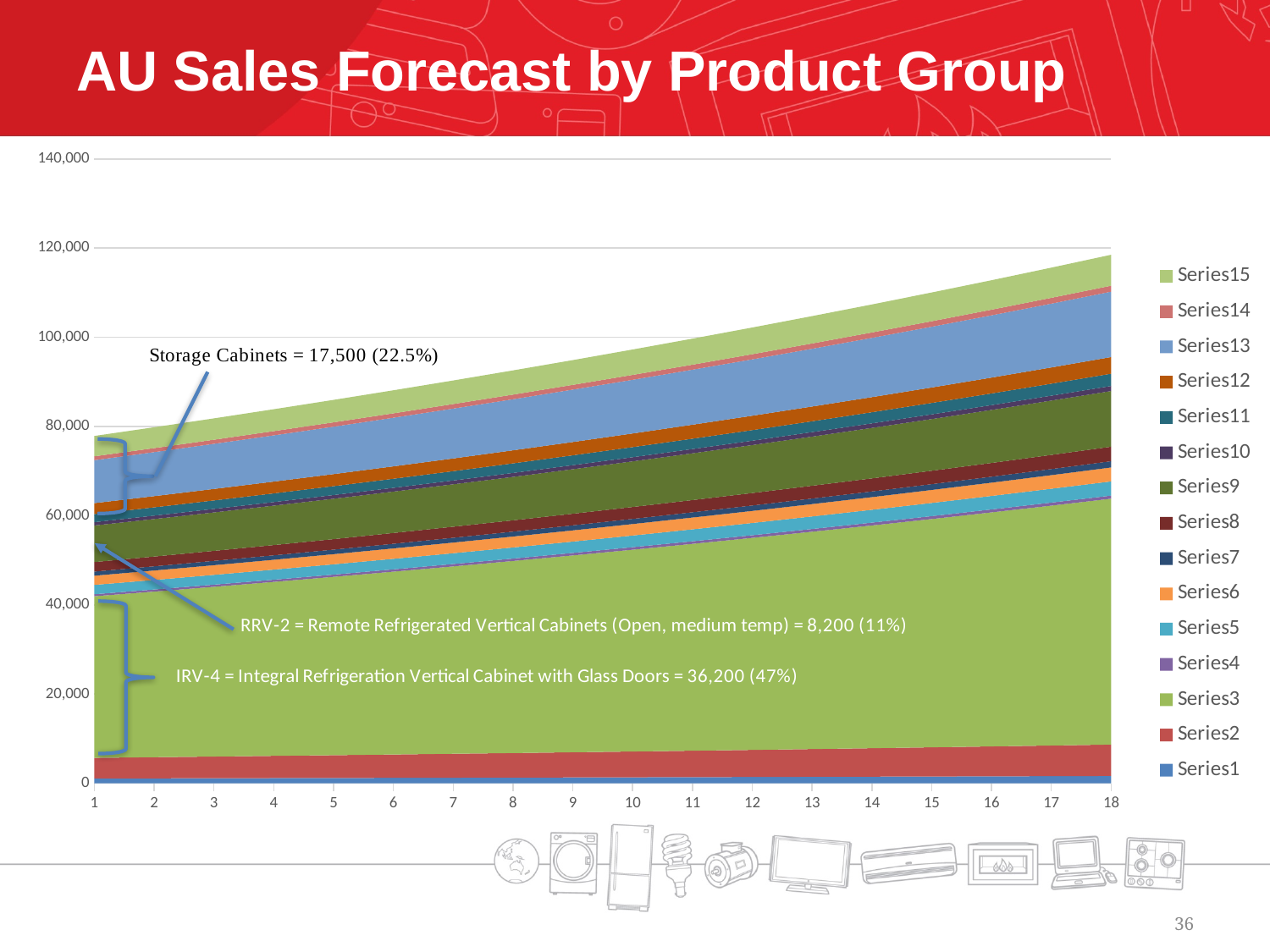
According to the annotation, what is the value for Storage Cabinets? 17,500 Is the total stacked value at point 1 greater or less than 100,000? less How many series does the legend list? 15 What share does the annotation give for RRV-2 (Remote Refrigerated Vertical Cabinets)? 11% According to the annotation, what is the value for IRV-4 (Integral Refrigeration Vertical Cabinet with Glass Doors)? 36,200 What is the difference between the annotated values for IRV-4 (36,200) and RRV-2 (8,200)? 28,000 What kind of chart is shown on the slide? Stacked area chart How many points are there along the x axis? 18 Does the total stacked value rise or fall from point 1 to point 18? Rises Which is larger according to the annotations, IRV-4 or Storage Cabinets? IRV-4 What is the title of the chart on the slide? AU Sales Forecast by Product Group Is the total stacked value at point 18 greater or less than 100,000? greater